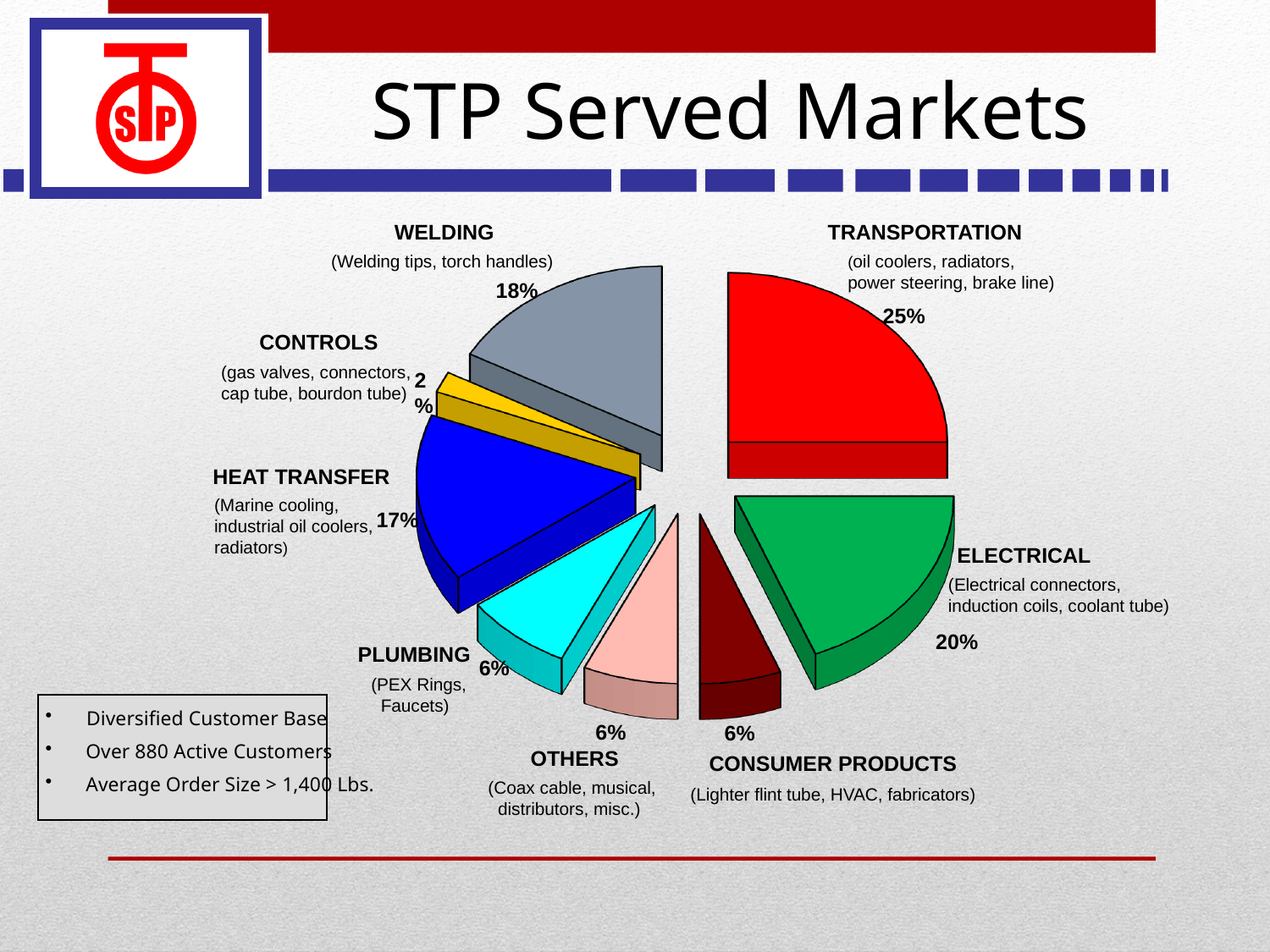
What share of the pie does Welding hold? 18% What share of the pie does Transportation hold? 25% Which market segment has the largest share of the pie? Transportation What kind of chart is shown on the slide? pie chart What is the title of the slide containing the pie chart? STP Served Markets How many market segments are shown in the pie chart? 8 What is the difference between the Transportation share and the Electrical share? 5% What share of the pie does Heat Transfer hold? 17% What share of the pie does Electrical hold? 20% What share of the pie does Controls hold? 2% Which market segment has the smallest share of the pie? Controls Which is larger, the Welding share or the Heat Transfer share? Welding